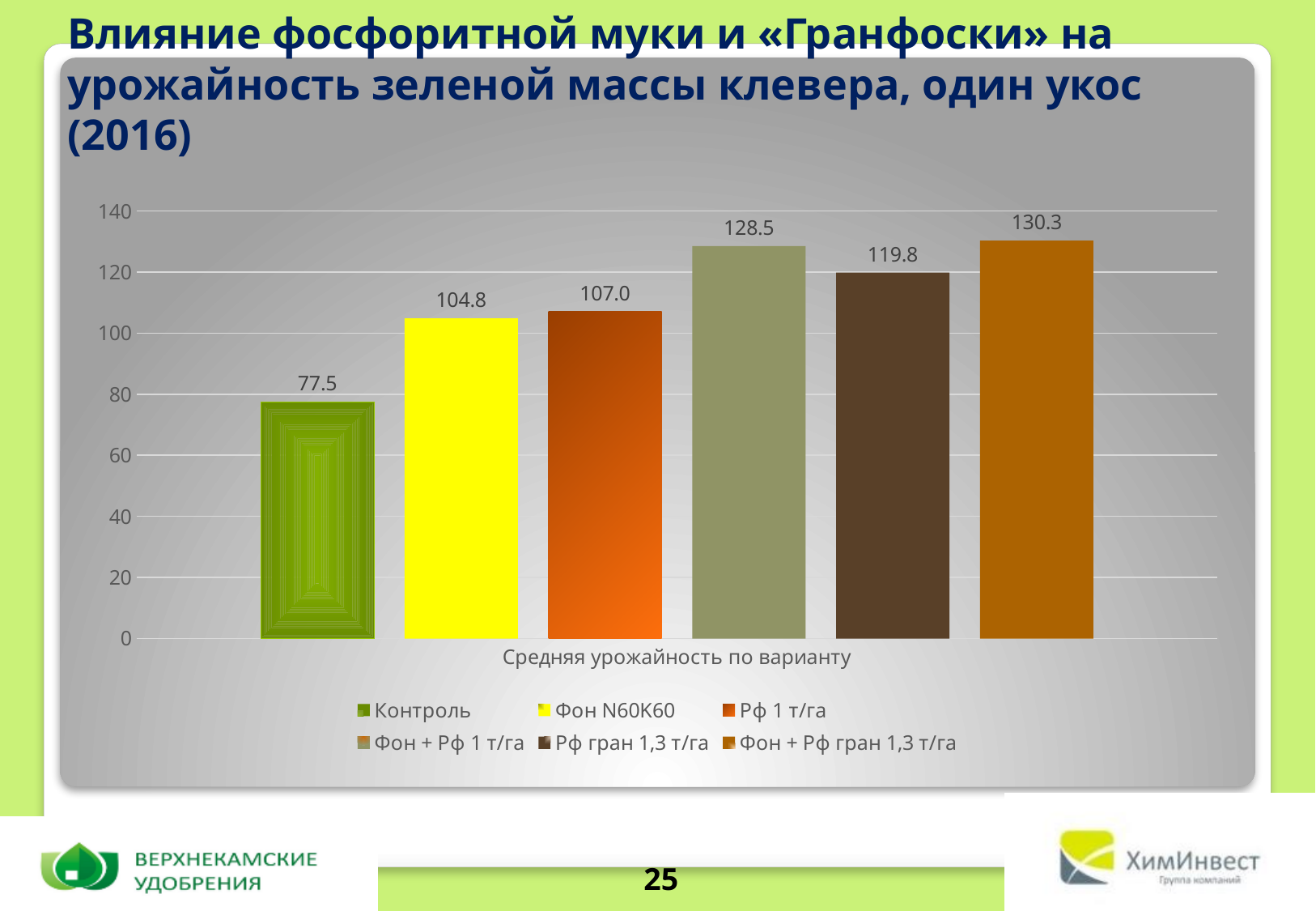
What kind of chart is shown on the slide? bar chart What is the value for Фон + Рф 1 т/га? 128.5 What is the value for Рф гран 1,3 т/га? 119.8 Which series has the lowest value? Контроль Which series has the highest value? Фон + Рф гран 1,3 т/га What is the difference between the values for Фон + Рф 1 т/га and Фон N60K60? 23.7 What is the value for Фон N60K60? 104.8 How many series does the legend list? 6 What is the label on the x axis under the bars? Средняя урожайность по варианту Which is larger, the value for Рф 1 т/га or the value for Рф гран 1,3 т/га? Рф гран 1,3 т/га What is the difference between the values for Фон + Рф гран 1,3 т/га and Контроль? 52.8 What is the value for Контроль? 77.5